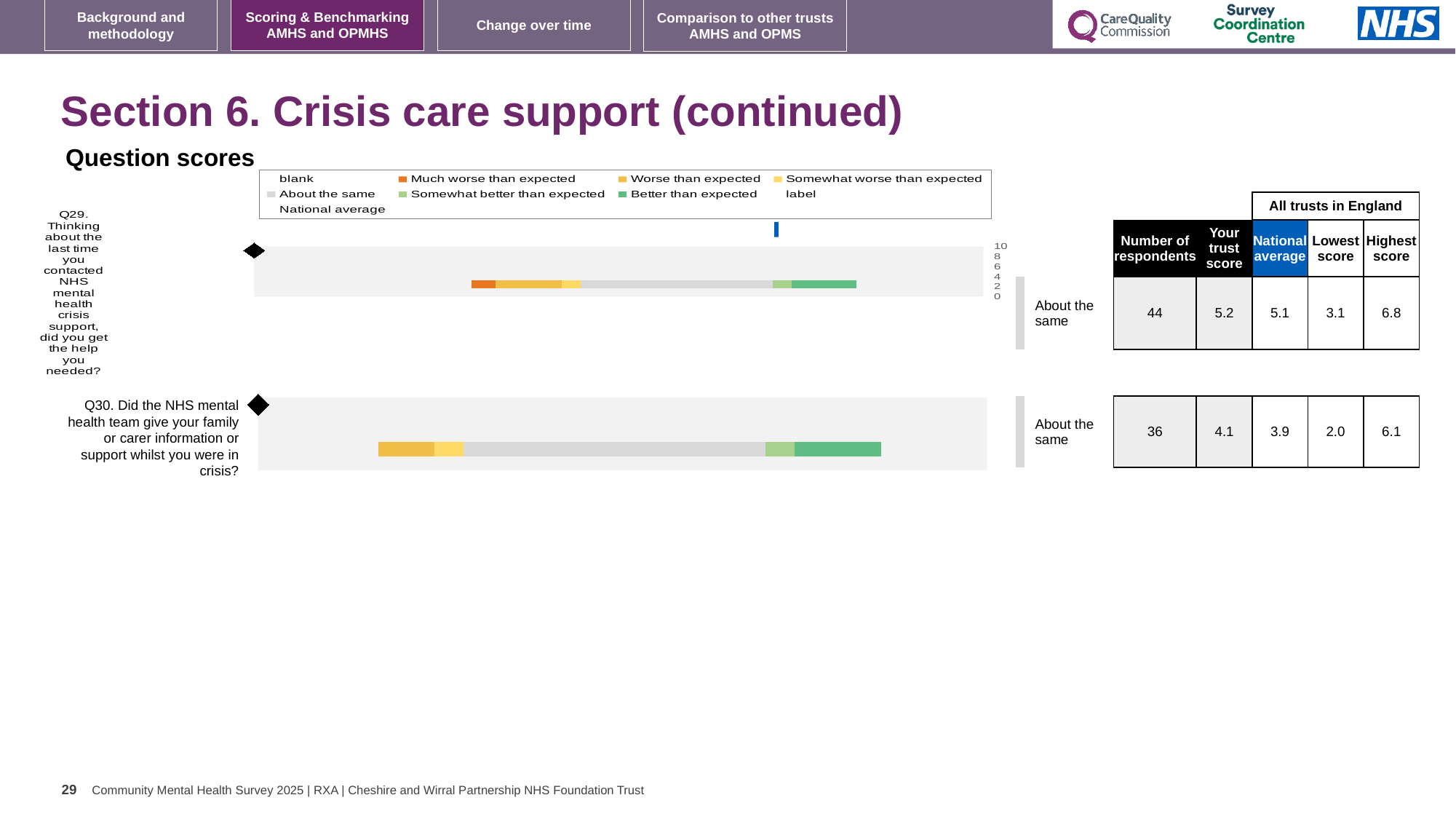
By how much does the trust score for Q30 exceed the national average for Q30? 0.2 What is the highest score among all trusts in England for Q30? 6.1 Which question has the higher trust score, Q29 or Q30? Q29 What is the trust score for Q30 (information or support for family or carer whilst in crisis)? 4.1 What is the difference between the highest and lowest scores for Q29? 3.7 What is the national average score for Q29? 5.1 What is the number of respondents for Q29 in the table next to the chart? 44 What is the lowest score among all trusts in England for Q29? 3.1 How many questions (bars) are plotted in the question scores chart? 2 What benchmark category is shown for Q30 next to the chart? About the same What kind of chart is used to show the question scores on this slide? bar chart In the chart legend, what colour represents 'Better than expected'? green